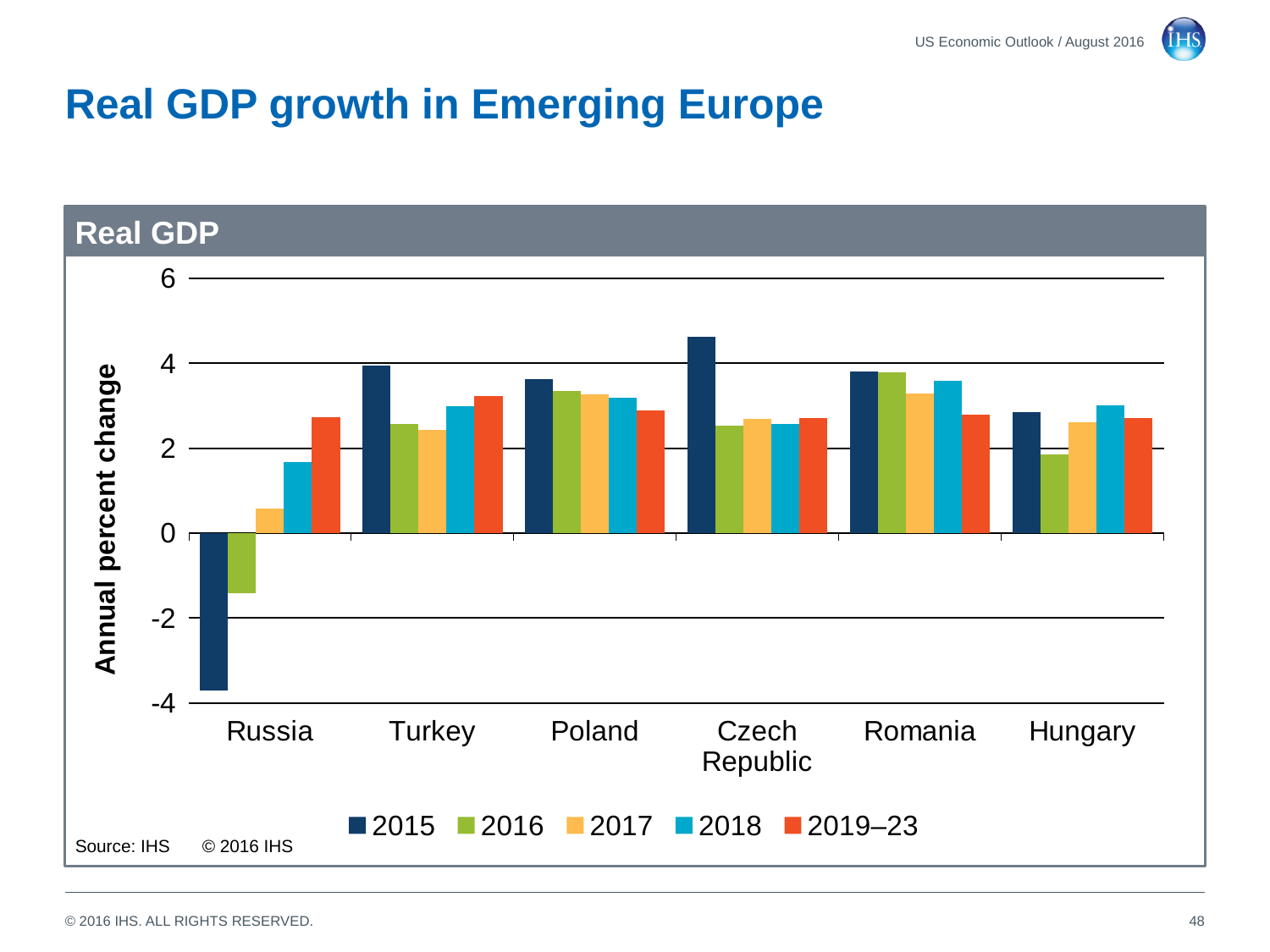
What is the label on the vertical axis? Annual percent change What type of chart is shown on the slide? Bar chart Which country has the lowest 2015 value? Russia Is the 2015 value for the Czech Republic greater or less than 4? greater Is the 2015 value for Russia greater or less than -2? less Which country has the highest 2015 value? Czech Republic How many series does the legend list? 5 Which is larger for Russia, the 2016 value or the 2017 value? 2017 Is the 2019–23 value for Romania greater or less than 4? less What is the last entry in the legend? 2019–23 For Russia, do the values rise or fall from 2015 through 2019–23? rise How many countries are shown on the x axis? 6